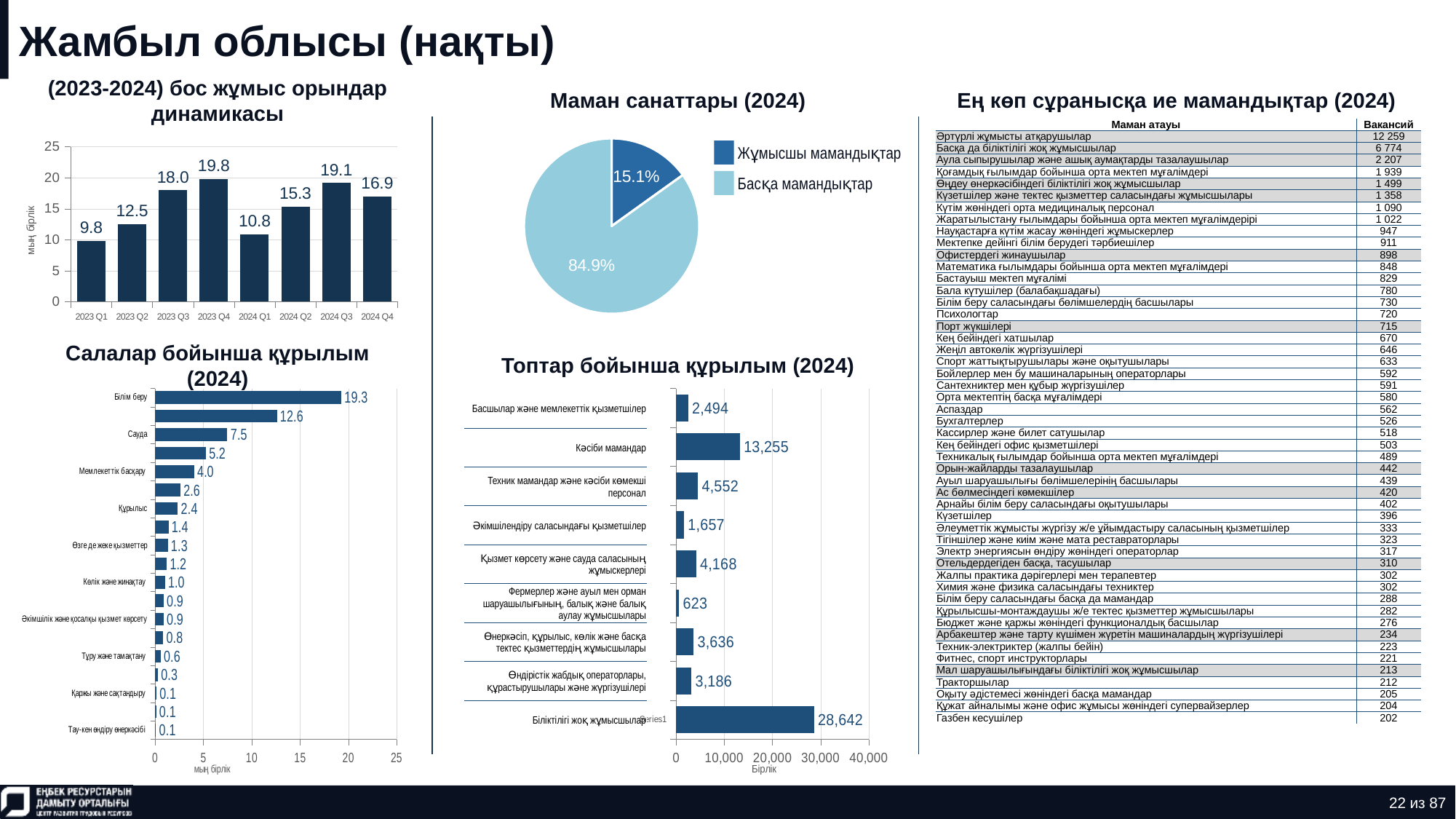
In the chart titled '(2023-2024) бос жұмыс орындар динамикасы', what kind of chart is it? Bar chart In the pie chart titled 'Маман санаттары (2024)', what share does 'Жұмысшы мамандықтар' have? 15.1% In the chart titled 'Топтар бойынша құрылым (2024)', which category has the lowest value? Фермерлер және ауыл мен орман шаруашылығының, балық және балық аулау жұмысшылары In the chart titled '(2023-2024) бос жұмыс орындар динамикасы', what is the value for 2023 Q4? 19.8 In the chart titled 'Салалар бойынша құрылым (2024)', what is the value for 'Сауда'? 7.5 In the chart titled 'Топтар бойынша құрылым (2024)', what is the value for 'Кәсіби мамандар'? 13,255 In the chart titled '(2023-2024) бос жұмыс орындар динамикасы', what is the difference between the values for 2024 Q3 and 2024 Q1? 8.3 In the chart titled '(2023-2024) бос жұмыс орындар динамикасы', which quarter has the lowest value? 2023 Q1 In the pie chart titled 'Маман санаттары (2024)', how many series does the legend list? 2 In the chart titled 'Топтар бойынша құрылым (2024)', which is larger: the value for 'Техник мамандар және кәсіби көмекші персонал' or for 'Қызмет көрсету және сауда саласының жұмыскерлері'? Техник мамандар және кәсіби көмекші персонал In the chart titled 'Салалар бойынша құрылым (2024)', which category has the highest value? Білім беру In the chart titled '(2023-2024) бос жұмыс орындар динамикасы', how many quarters are plotted? 8